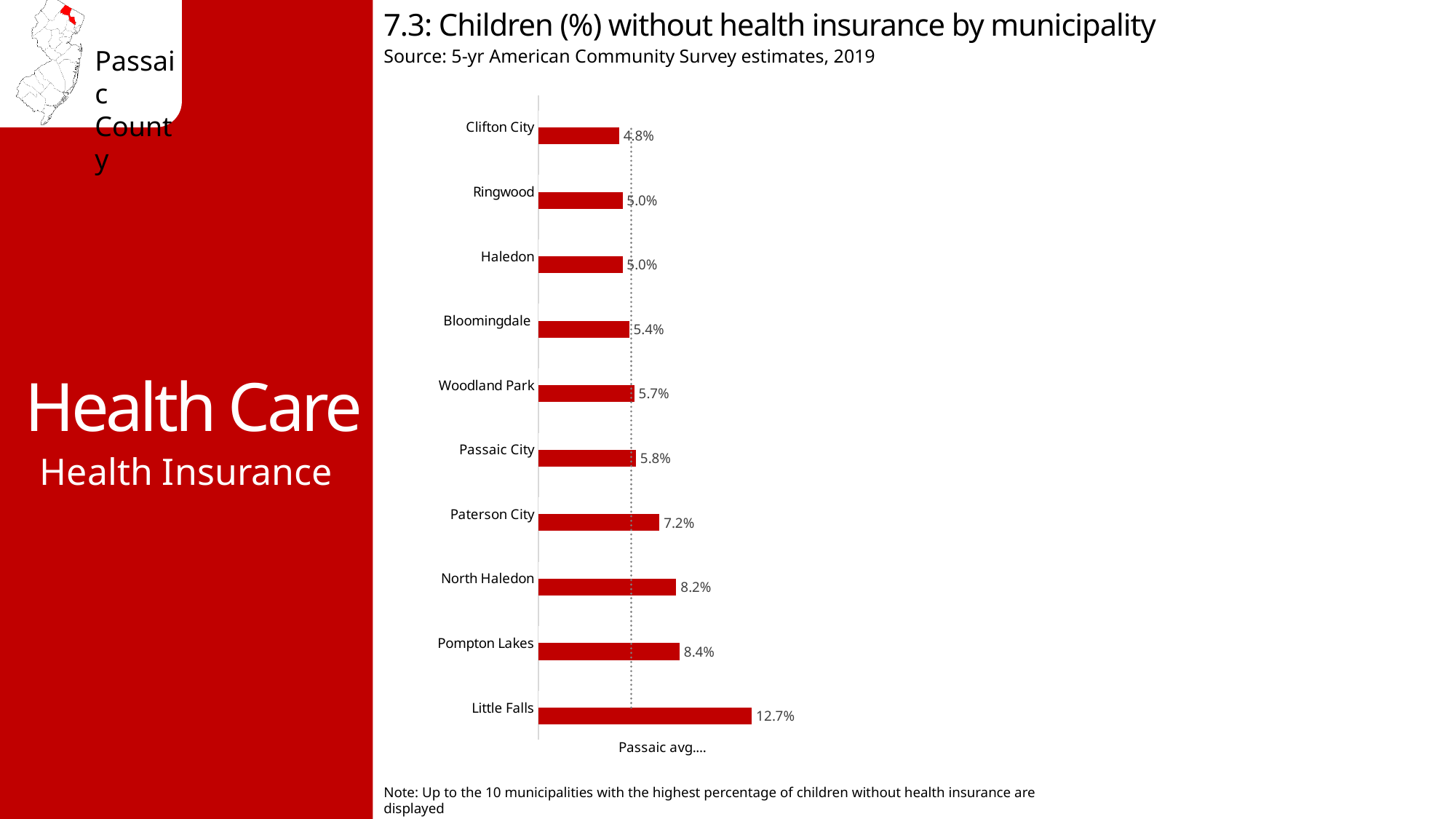
What percentage is shown for Woodland Park? 5.7% What type of chart is used on this slide? Bar chart What percentage of children in Little Falls are without health insurance? 12.7% What is the source of the data shown in the chart? 5-yr American Community Survey estimates, 2019 Which has a higher value, Pompton Lakes or North Haledon? Pompton Lakes What is the value shown for Paterson City? 7.2% Which municipality has the highest percentage of children without health insurance? Little Falls Which has a higher percentage of children without health insurance, Paterson City or Passaic City? Paterson City What is the difference between the values for Little Falls and Pompton Lakes? 4.3% Which municipality has the lowest percentage of children without health insurance? Clifton City What is the difference between the values for North Haledon and Passaic City? 2.4% How many municipalities are shown in the chart? 10